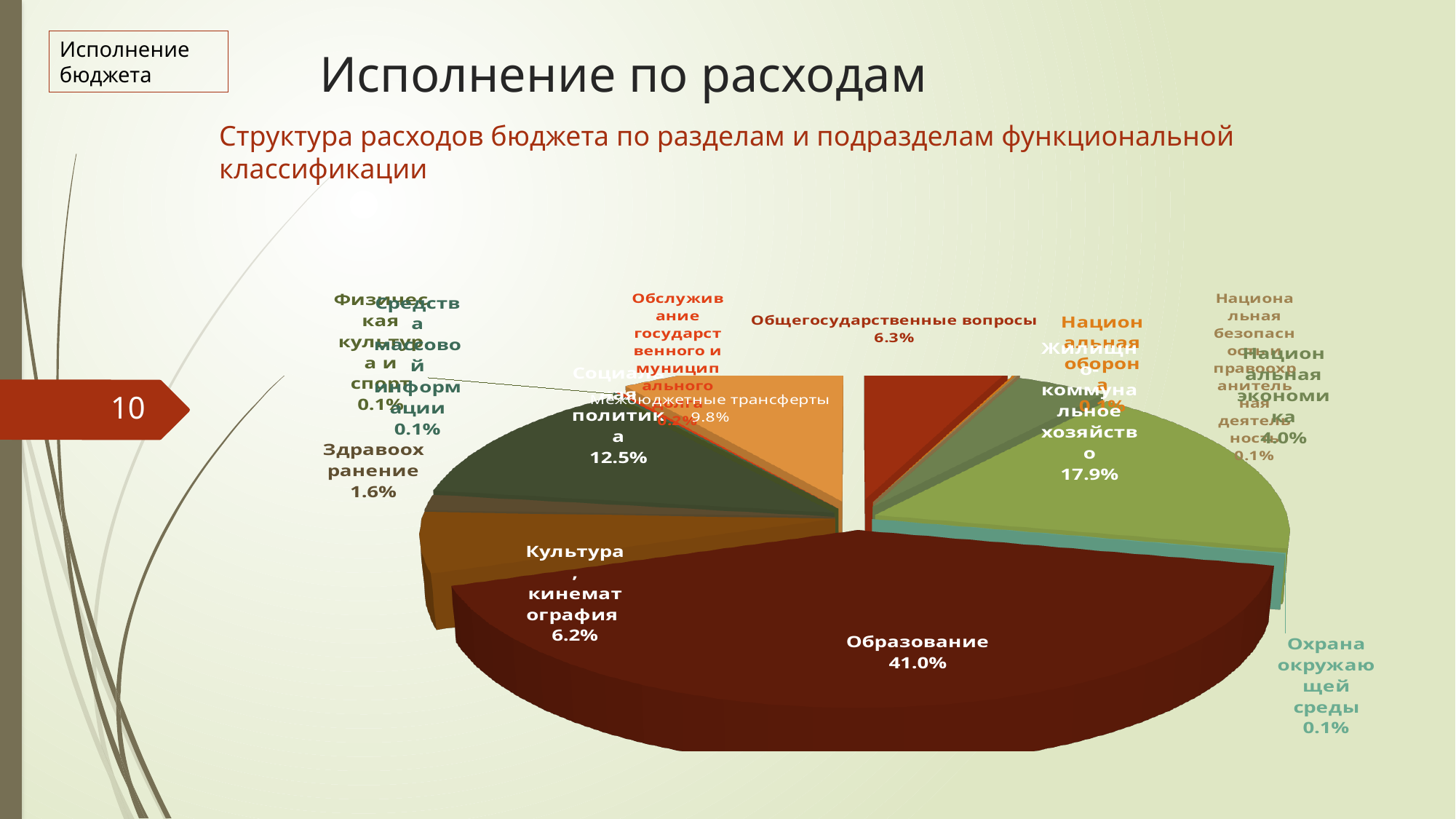
What kind of chart is shown on the slide? pie chart What is the share for Социальная политика? 12.5% Which is larger, the share for Социальная политика or the share for Межбюджетные трансферты? Социальная политика What is the share for Охрана окружающей среды? 0.1% What is the difference in percentage points between Образование and Жилищно-коммунальное хозяйство? 23.1 What is the share for Образование? 41.0% Which category has the largest share of the pie? Образование What is the share for Межбюджетные трансферты? 9.8% What is the share for Здравоохранение? 1.6% What is the share for Жилищно-коммунальное хозяйство? 17.9% What is the subtitle describing the chart on the slide? Структура расходов бюджета по разделам и подразделам функциональной классификации What is the share for Общегосударственные вопросы? 6.3%